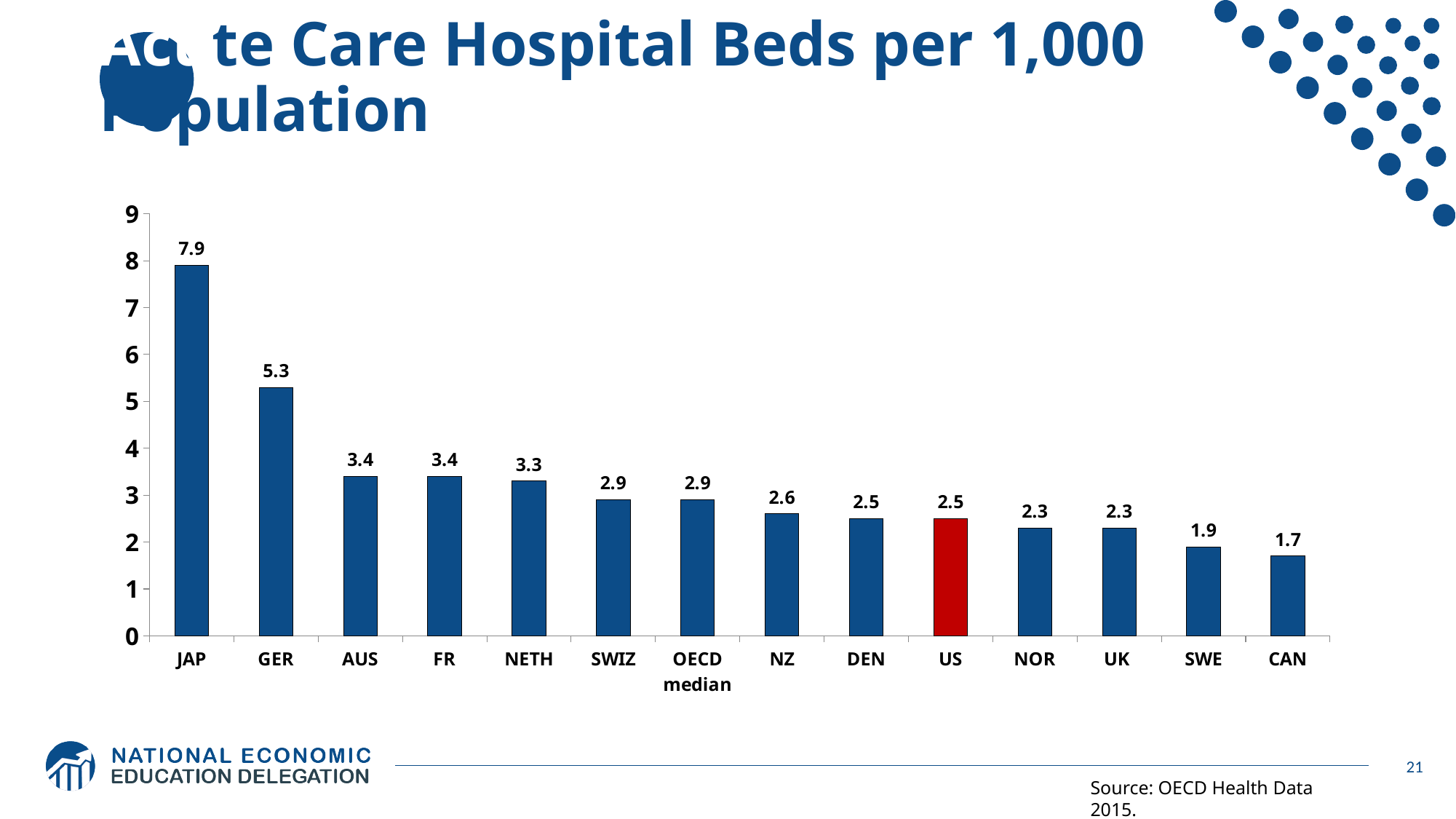
Is the value for GER greater or less than 5? greater What is the difference between the OECD median and the US value? 0.4 Which country has the lowest number of acute care hospital beds per 1,000 population? CAN What is the difference between the values for JAP and GER? 2.6 What is the value for JAP? 7.9 Which country has the highest number of acute care hospital beds per 1,000 population? JAP Which bar is coloured red instead of blue? US What is the value for the US? 2.5 How many bars are shown in the chart? 14 What kind of chart is shown on the slide? bar chart Which has a larger value, NETH or SWIZ? NETH What is the value for the OECD median? 2.9